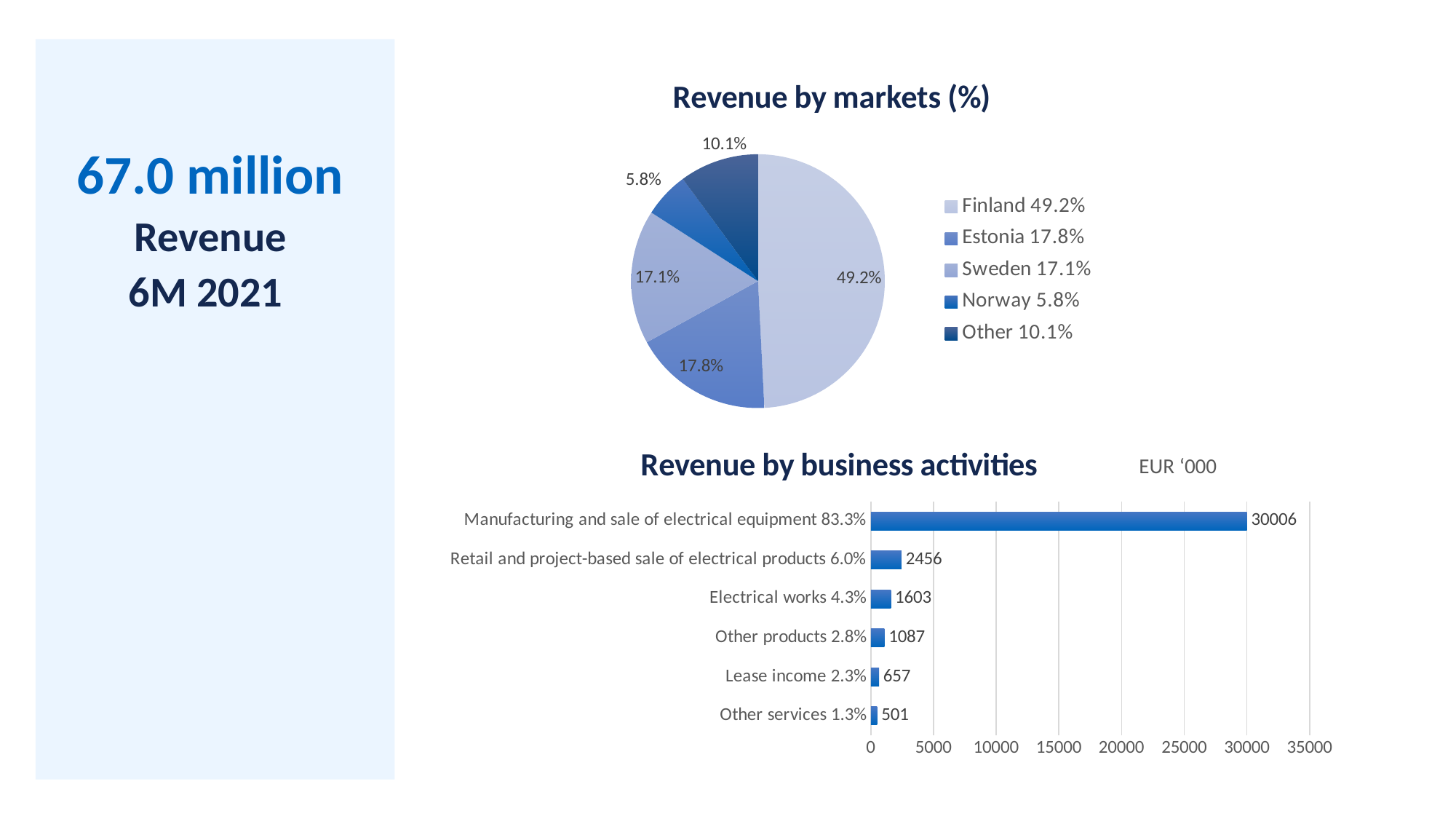
In the 'Revenue by markets (%)' chart, what share of revenue comes from Finland? 49.2% In the 'Revenue by business activities' chart, what is the value for Lease income? 657 In the 'Revenue by markets (%)' chart, what share of revenue comes from Norway? 5.8% In the 'Revenue by markets (%)' chart, how many markets are shown in the legend? 5 In the 'Revenue by business activities' chart, what is the value for Electrical works? 1603 What kind of chart is 'Revenue by markets (%)'? Pie chart What kind of chart is 'Revenue by business activities'? Bar chart In the 'Revenue by markets (%)' chart, which market has the largest share? Finland In the 'Revenue by business activities' chart, how many business activities are shown? 6 In the 'Revenue by business activities' chart, which activity has the lowest revenue? Other services In the 'Revenue by business activities' chart, what is the difference between Retail and project-based sale of electrical products and Other products? 1369 In the 'Revenue by markets (%)' chart, which market has the smallest share? Norway